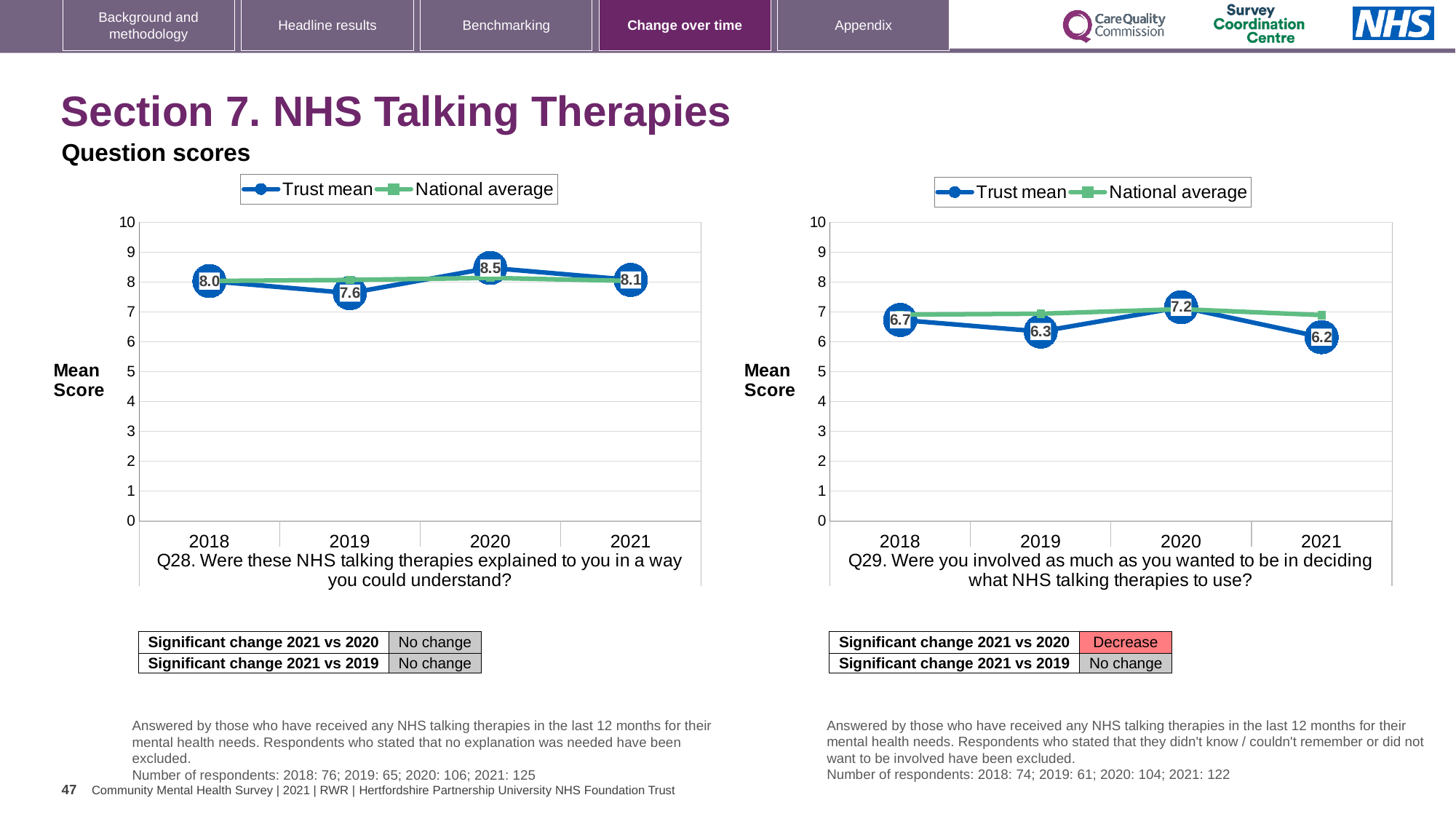
In the Q29 chart (right), what is the Trust mean for 2018? 6.7 In the Q28 chart (left), what is the Trust mean for 2019? 7.6 In the Q29 chart (right), is the Trust mean for 2021 larger or smaller than the Trust mean for 2020? smaller In the Q29 chart (right), what is the Trust mean for 2021? 6.2 In the Q28 chart (left), what is the difference between the Trust mean in 2020 and in 2019? 0.9 In the Q29 chart (right), is the National average for 2021 greater or less than 5? greater In the Q29 chart (right), which year has the highest Trust mean? 2020 How many series does the legend of the Q28 chart (left) list? 2 In the Q28 chart (left), which year has the lowest Trust mean? 2019 In the Q28 chart (left), which year has the highest Trust mean? 2020 In the Q28 chart (left), what is the Trust mean for 2020? 8.5 What kind of chart is the Q29 chart (right)? line chart